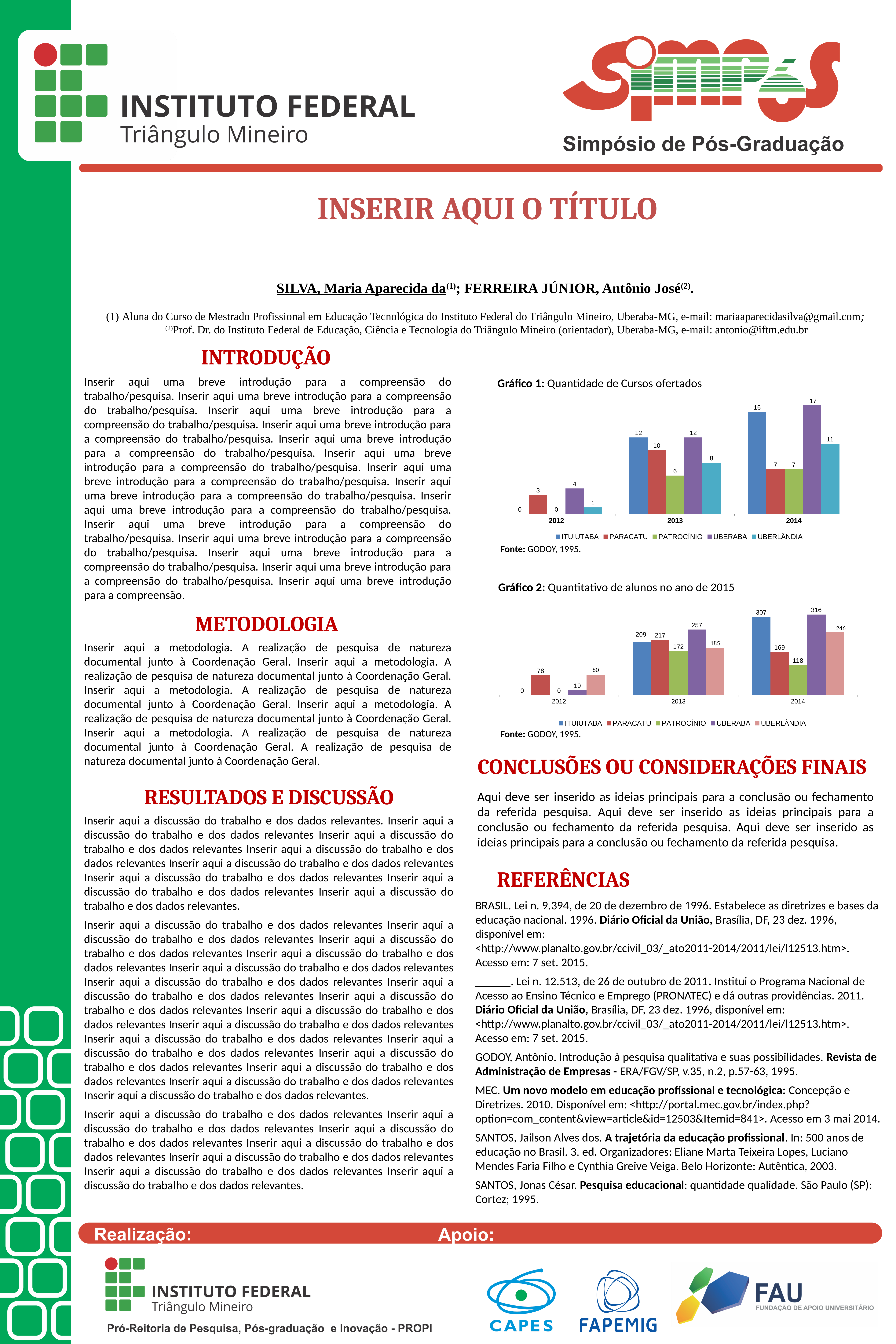
In Gráfico 2 (Quantitativo de alunos no ano de 2015), which is larger in 2013: PARACATU or ITUIUTABA? PARACATU In Gráfico 2 (Quantitativo de alunos no ano de 2015), which series has the lowest value in 2014? PATROCÍNIO In Gráfico 1 (Quantidade de Cursos ofertados), what is the value for UBERABA in 2014? 17 In Gráfico 2 (Quantitativo de alunos no ano de 2015), what is the difference between UBERABA and ITUIUTABA in 2014? 9 In Gráfico 1 (Quantidade de Cursos ofertados), which series has the highest value in 2014? UBERABA In Gráfico 1 (Quantidade de Cursos ofertados), does the value for ITUIUTABA rise or fall from 2012 to 2014? rise What kind of chart is Gráfico 2 (Quantitativo de alunos no ano de 2015)? bar chart In Gráfico 1 (Quantidade de Cursos ofertados), what is the difference between ITUIUTABA and UBERLÂNDIA in 2014? 5 In Gráfico 1 (Quantidade de Cursos ofertados), what is the value for PARACATU in 2013? 10 In Gráfico 2 (Quantitativo de alunos no ano de 2015), what is the value for PATROCÍNIO in 2014? 118 In Gráfico 1 (Quantidade de Cursos ofertados), how many series does the legend list? 5 In Gráfico 2 (Quantitativo de alunos no ano de 2015), what is the value for UBERABA in 2013? 257